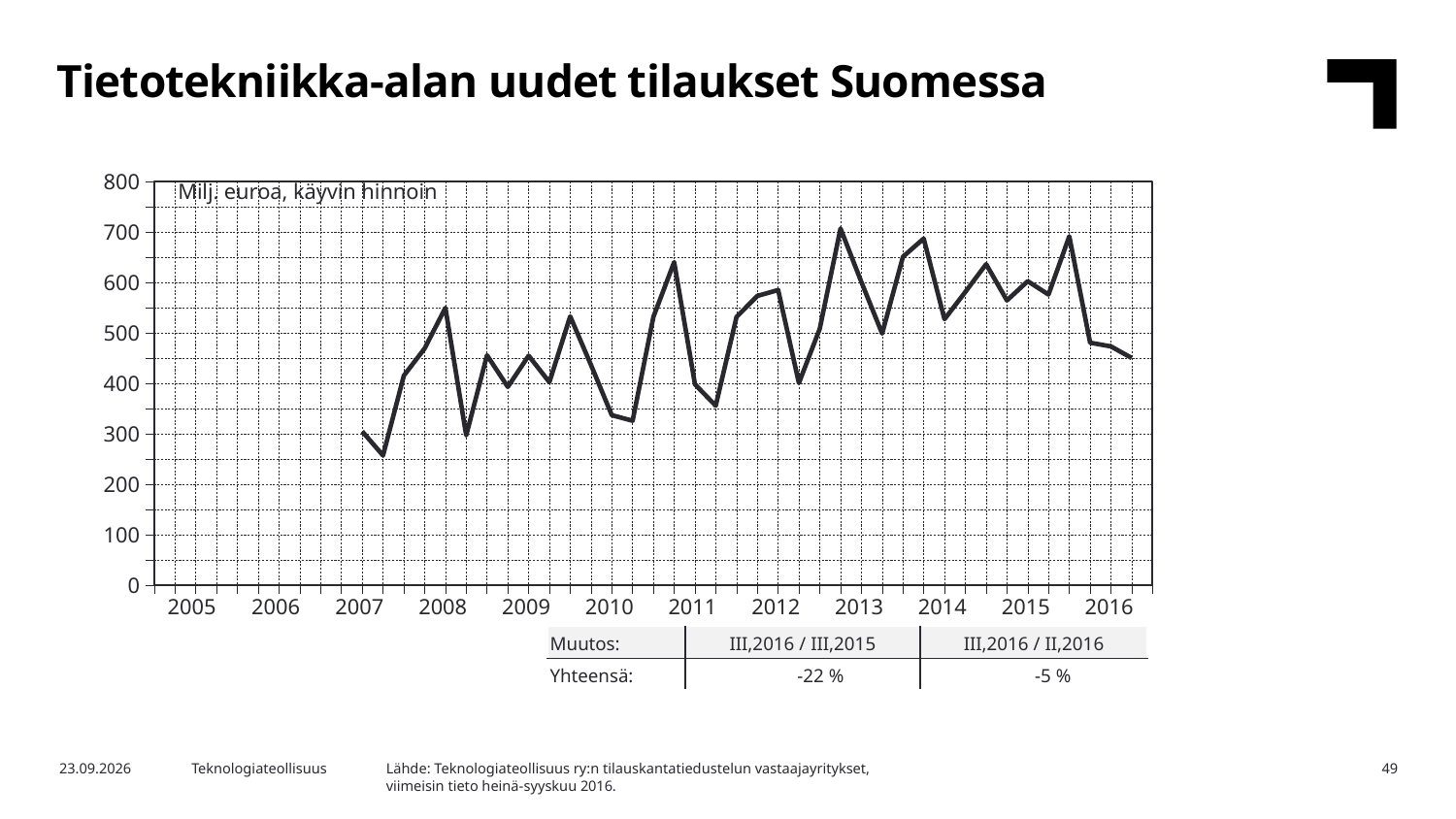
Is the value at the start of 2011 greater or less than 600? greater What kind of chart is shown on the slide? line chart How many year labels are shown on the horizontal axis? 12 Does the line rise or fall from the start of 2007 to the start of 2008? rise What unit is stated inside the chart area? Milj. euroa, käyvin hinnoin Is the last plotted value in 2016 greater or less than 500? less In which year does the line reach its lowest point? 2007 What is the title of the chart? Tietotekniikka-alan uudet tilaukset Suomessa Is the value at the start of 2014 greater or less than 600? greater What is the highest value shown on the vertical axis? 800 According to the table below the chart, what is the change for III,2016 / III,2015? -22 %